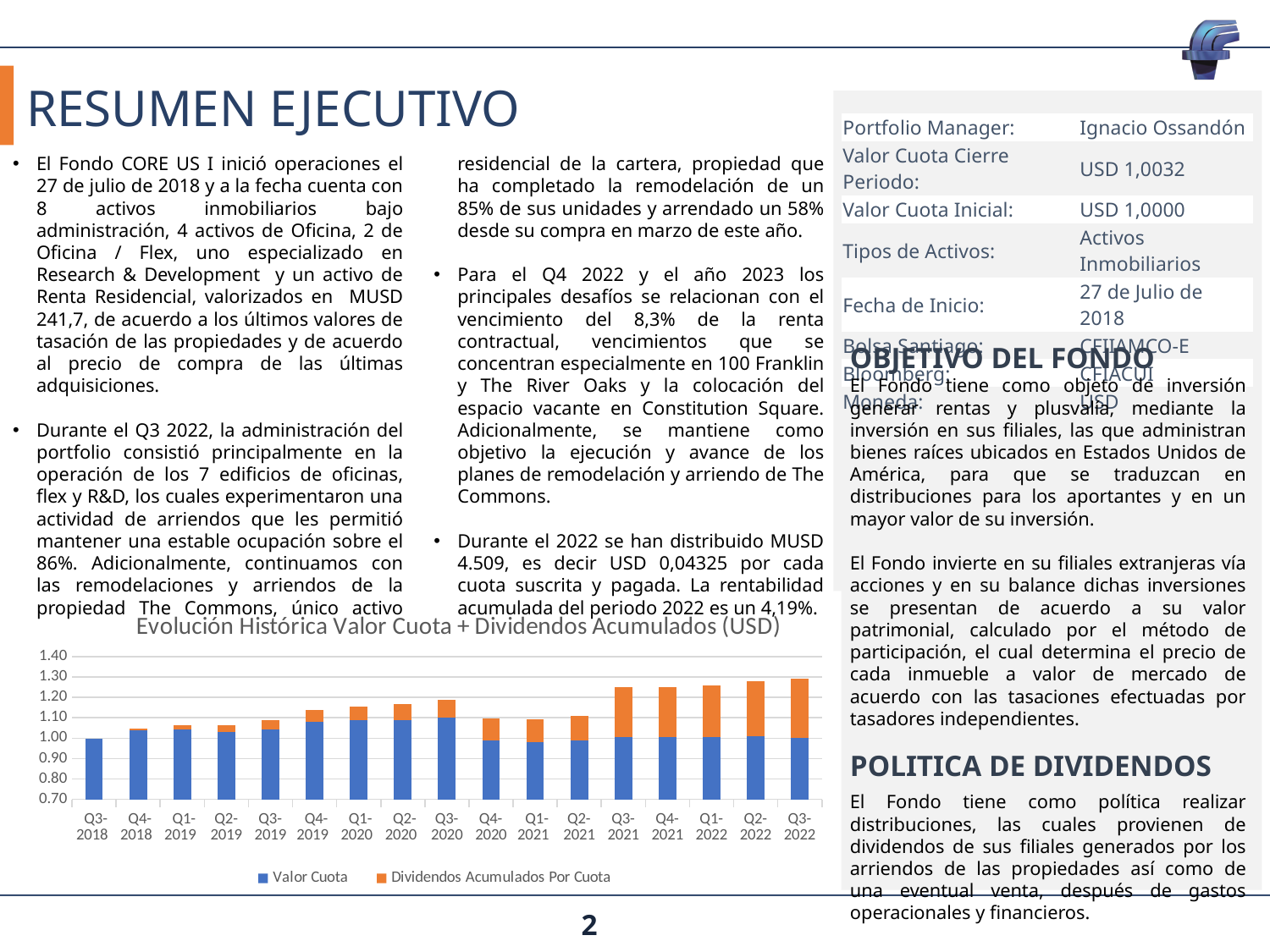
What is the title of the chart on the slide? Evolución Histórica Valor Cuota + Dividendos Acumulados (USD) Is the total bar for Q1-2019 greater or less than 1.10? less Overall, do the total bars rise or fall from Q3-2018 to Q3-2022? rise Which has the larger total bar, Q4-2020 or Q3-2021? Q3-2021 Which quarter has the lowest total bar in the chart? Q3-2018 Which quarter has the highest total bar in the chart? Q3-2022 What kind of chart is shown on the slide? Stacked bar chart Is the total bar for Q3-2018 greater or less than 1.10? less How many series does the chart's legend list? 2 How many quarters are plotted along the x axis of the chart? 17 Which two series are listed in the chart's legend? Valor Cuota and Dividendos Acumulados Por Cuota Is the total bar for Q3-2022 greater or less than 1.20? greater